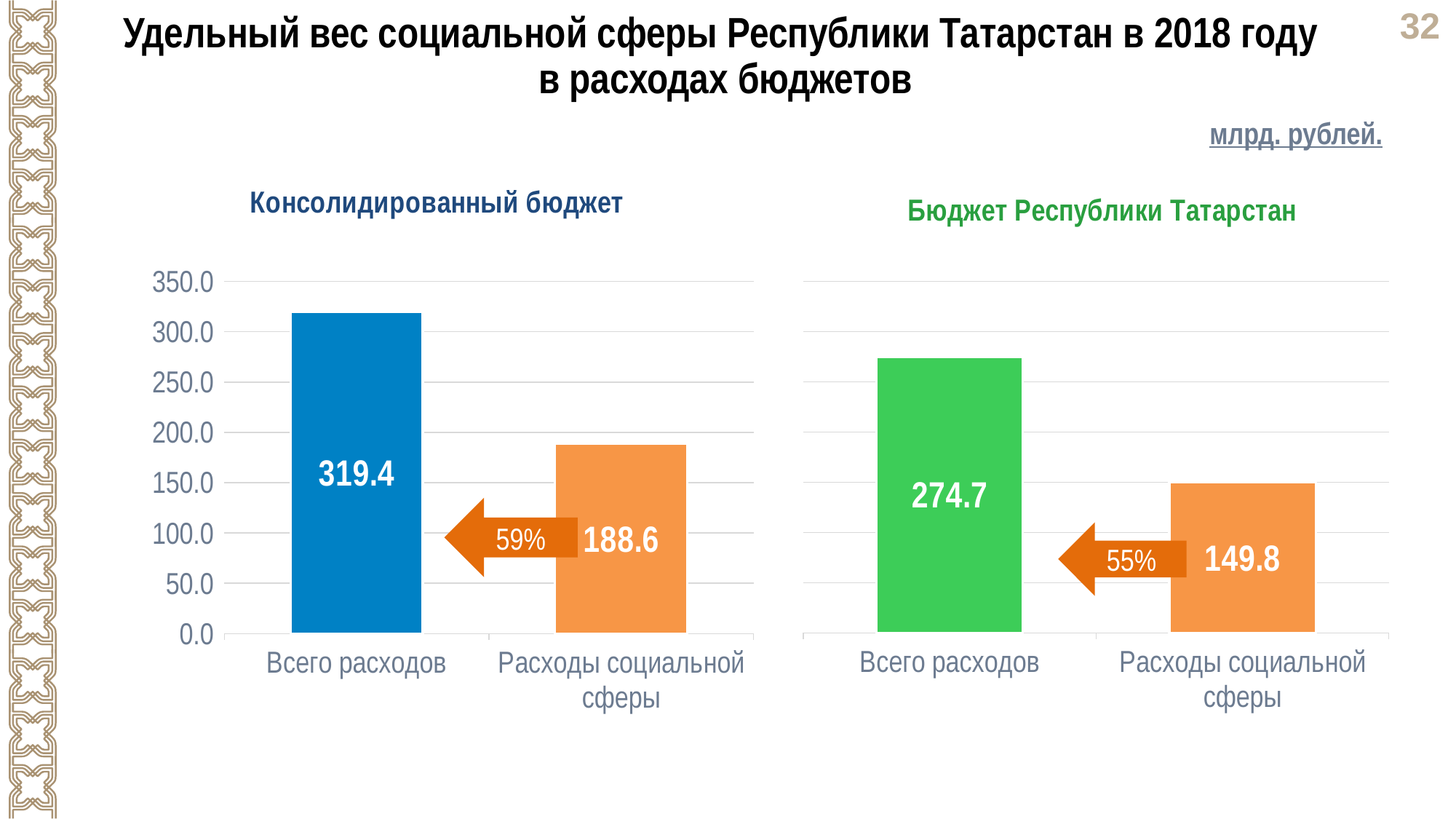
How many categories are shown in the 'Бюджет Республики Татарстан' chart? 2 Which is larger: 'Всего расходов' in the 'Консолидированный бюджет' chart or 'Всего расходов' in the 'Бюджет Республики Татарстан' chart? Консолидированный бюджет In the 'Бюджет Республики Татарстан' chart, what is the value for 'Расходы социальной сферы'? 149.8 What type of chart is the 'Консолидированный бюджет' chart? Bar chart In the 'Бюджет Республики Татарстан' chart, what is the value for 'Всего расходов'? 274.7 In the 'Консолидированный бюджет' chart, what is the value for 'Расходы социальной сферы'? 188.6 In the 'Консолидированный бюджет' chart, what is the value for 'Всего расходов'? 319.4 In the 'Консолидированный бюджет' chart, what percentage share is shown on the arrow between the two bars? 59% In the 'Бюджет Республики Татарстан' chart, what is the difference between 'Всего расходов' and 'Расходы социальной сферы'? 124.9 In the 'Бюджет Республики Татарстан' chart, which category has the lowest value? Расходы социальной сферы In the 'Консолидированный бюджет' chart, what is the difference between 'Всего расходов' and 'Расходы социальной сферы'? 130.8 In the 'Консолидированный бюджет' chart, which category has the highest value? Всего расходов